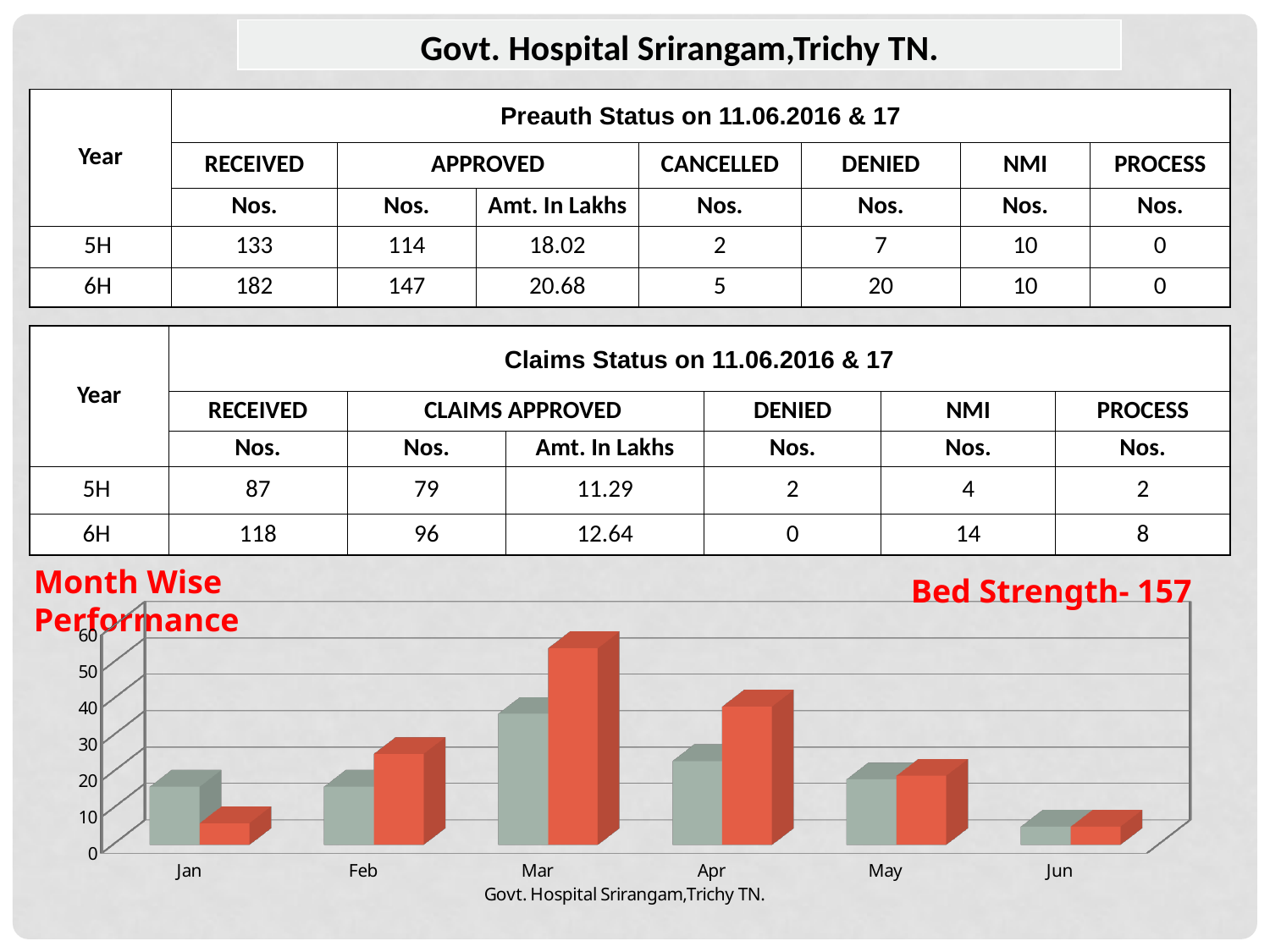
What text appears as the title below the x axis of the Month Wise Performance chart? Govt. Hospital Srirangam,Trichy TN. In the Month Wise Performance chart, is the grey bar for Mar greater or less than 40? less In the Month Wise Performance chart, which month has the tallest red bar? Mar In the Month Wise Performance chart, which month has the shortest grey bar? Jun In the Month Wise Performance chart, is the red bar for Jan greater or less than 10? less What kind of chart is shown at the bottom of the slide under 'Month Wise Performance'? bar chart In the Month Wise Performance chart, is the red bar for Mar greater or less than 40? greater In the Month Wise Performance chart, which is larger for Jan: the grey bar or the red bar? the grey bar How many months are shown on the x axis of the Month Wise Performance chart? 6 In the Month Wise Performance chart, which month has the tallest grey bar? Mar How many bars are plotted for each month in the Month Wise Performance chart? 2